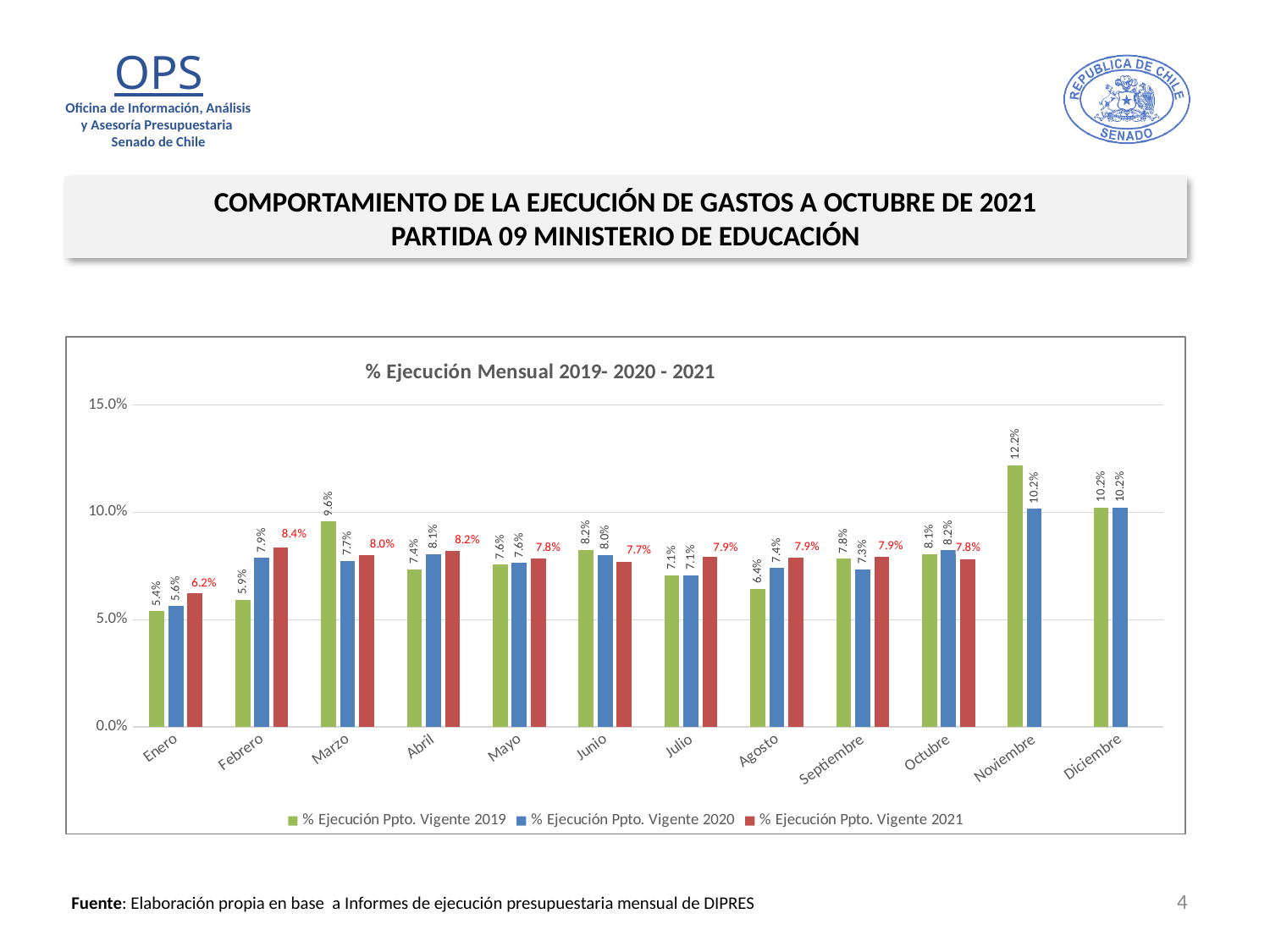
How many series does the legend list? 3 What is the title of the chart? % Ejecución Mensual 2019- 2020 - 2021 Which month has the highest value in the % Ejecución Ppto. Vigente 2019 series? Noviembre What is the value for Febrero in the % Ejecución Ppto. Vigente 2021 series? 8.4% What is the value for Noviembre in the % Ejecución Ppto. Vigente 2020 series? 10.2% How many months are shown on the x axis? 12 Which month has the lowest value in the % Ejecución Ppto. Vigente 2021 series? Enero What kind of chart is shown? Bar chart For Marzo, which is larger: the 2019 value or the 2020 value? 2019 Is the value for Noviembre in the 2019 series greater or less than 10.0%? greater What is the difference between the 2021 and 2019 values for Agosto? 1.5% What is the value for Marzo in the % Ejecución Ppto. Vigente 2019 series? 9.6%